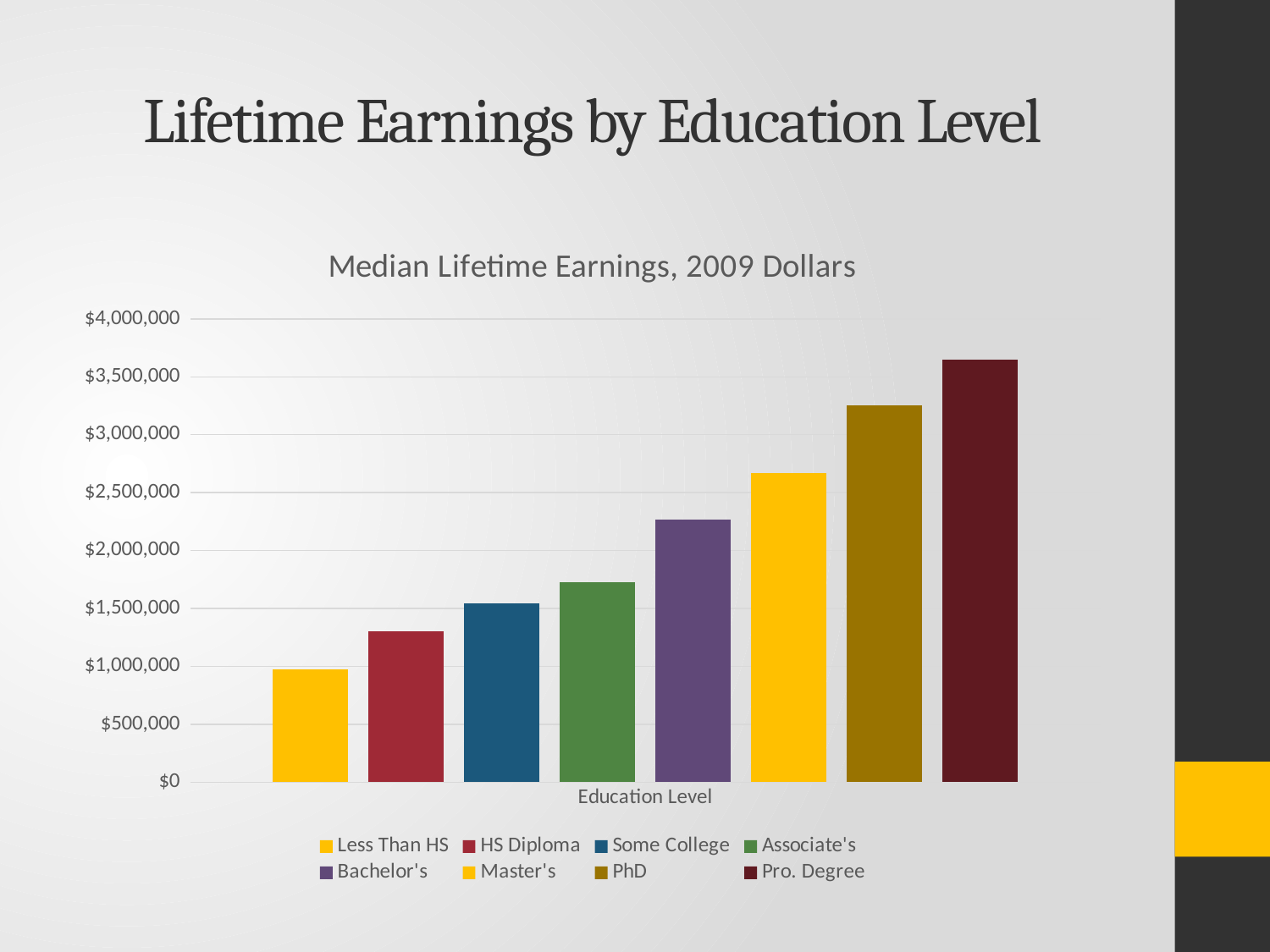
Is the value for PhD greater or less than $3,000,000? greater Which is larger, the value for Master's or the value for Bachelor's? Master's Which education level has the highest median lifetime earnings? Pro. Degree What kind of chart is shown on the slide? bar chart Is the value for HS Diploma greater or less than $1,000,000? greater Is the value for Bachelor's greater or less than $2,000,000? greater Which education level has the lowest median lifetime earnings? Less Than HS How many education levels are plotted in the chart? 8 How many entries does the legend list? 8 What is the title of the chart? Median Lifetime Earnings, 2009 Dollars Do the median lifetime earnings rise or fall as education level increases from left to right? rise